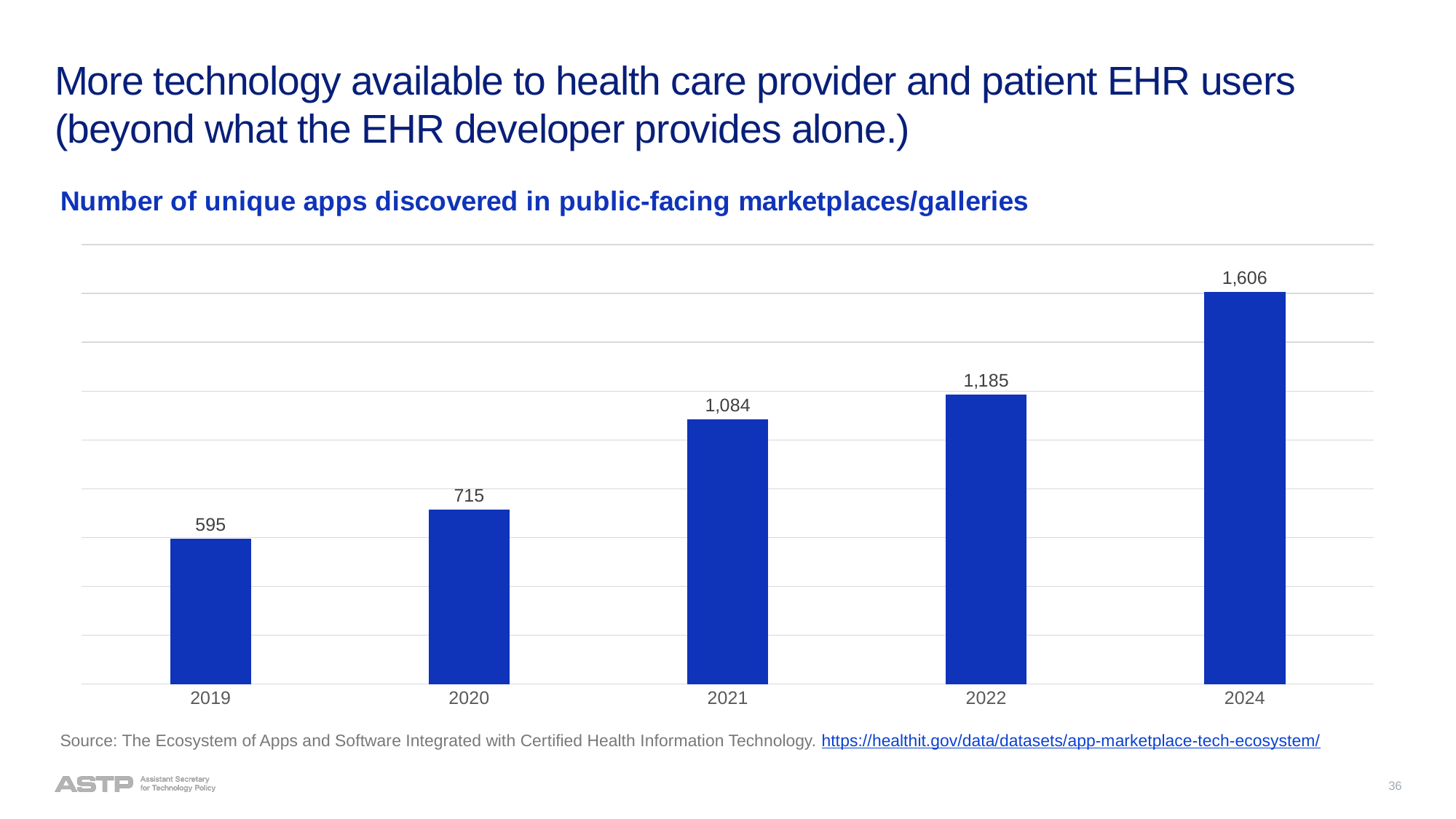
How many years are shown on the x axis of the chart? 5 Which year has the highest number of unique apps discovered? 2024 Which year has more unique apps discovered, 2021 or 2022? 2022 What is the number of unique apps discovered in 2024? 1,606 Do the values rise or fall from 2019 to 2024? Rise What is the number of unique apps discovered in 2021? 1,084 Which year has the lowest number of unique apps discovered? 2019 What is the difference between the number of unique apps in 2024 and in 2022? 421 What is the number of unique apps discovered in 2019? 595 What is the difference between the number of unique apps in 2020 and in 2019? 120 What is the title of the chart? Number of unique apps discovered in public-facing marketplaces/galleries What kind of chart is shown on the slide? Bar chart